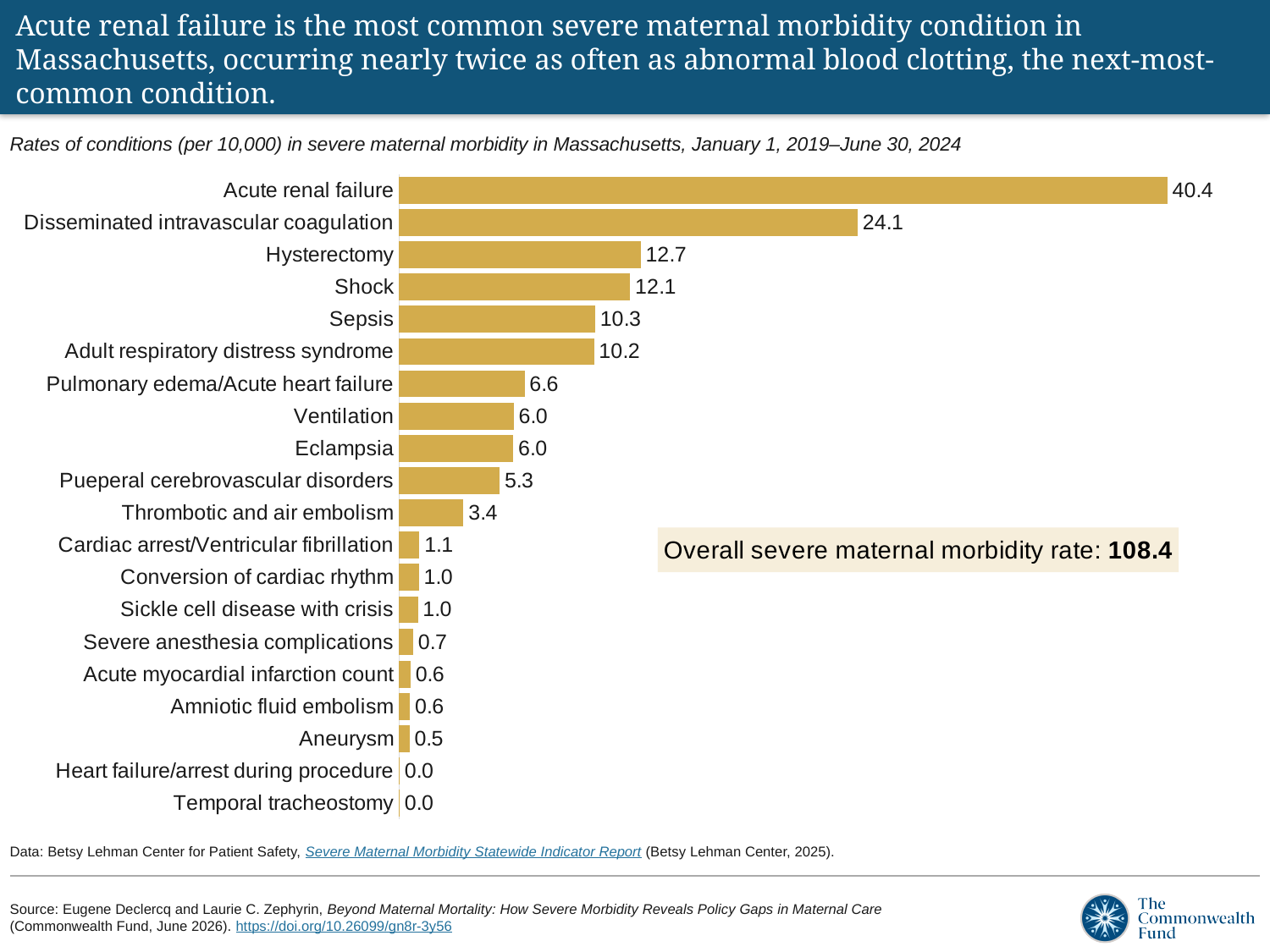
Which has a higher rate, Pueperal cerebrovascular disorders or Ventilation? Ventilation What is the difference between the rates for Hysterectomy and Shock? 0.6 What is the rate for Thrombotic and air embolism? 3.4 What is the rate for Acute renal failure? 40.4 What kind of chart is shown on the slide? Bar chart How many conditions are shown in the chart? 20 What is the overall severe maternal morbidity rate stated on the slide? 108.4 Which condition has the highest rate? Acute renal failure Which has a higher rate, Sepsis or Pulmonary edema/Acute heart failure? Sepsis What is the rate for Hysterectomy? 12.7 How many conditions have a rate of 0.0? 2 What is the difference between the rates for Acute renal failure and Disseminated intravascular coagulation? 16.3